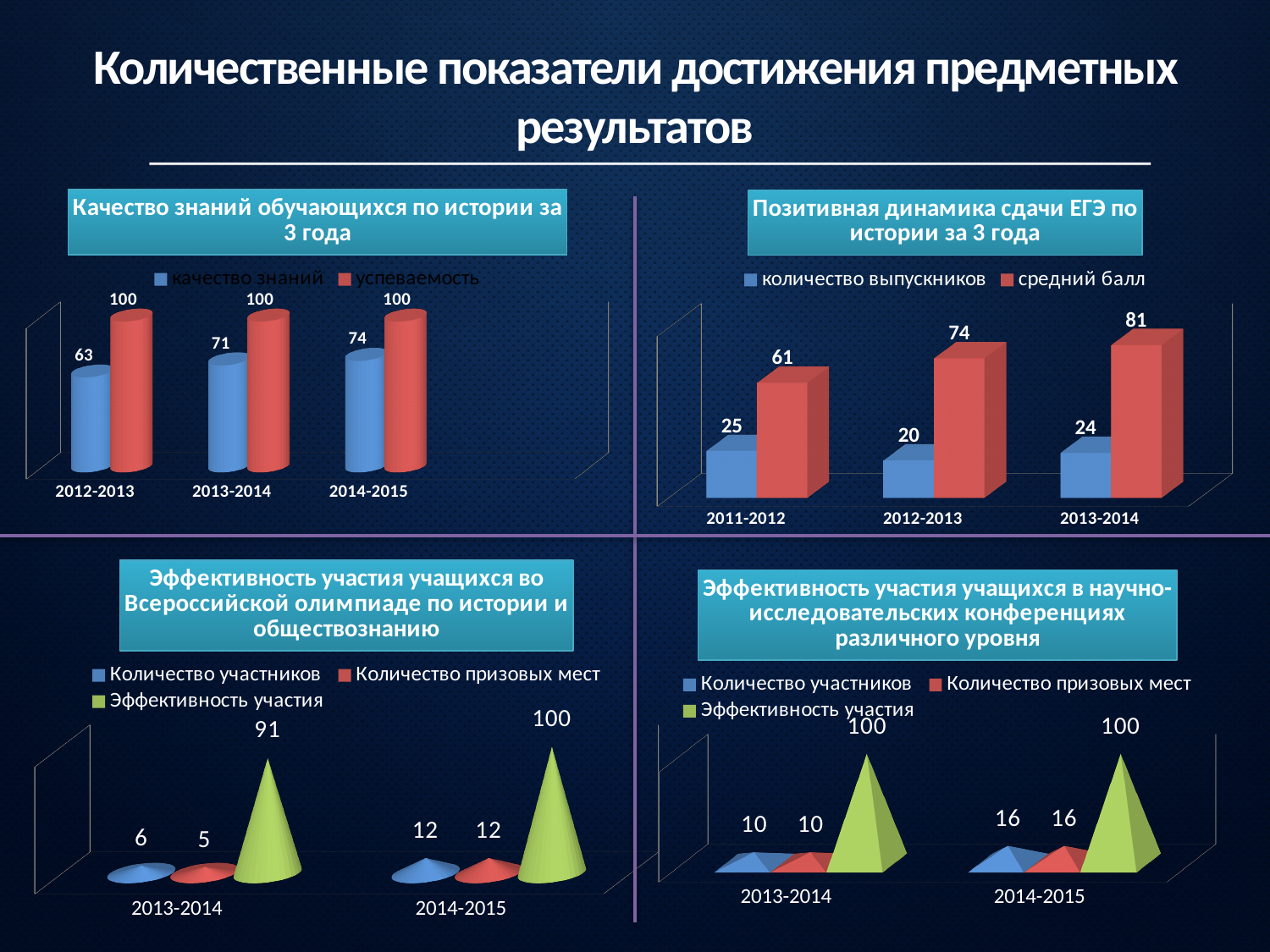
In the chart 'Эффективность участия учащихся в научно-исследовательских конференциях различного уровня', what is the 'Количество участников' for 2014-2015? 16 In the chart 'Эффективность участия учащихся во Всероссийской олимпиаде по истории и обществознанию', what is the 'Эффективность участия' value for 2013-2014? 91 In the chart 'Эффективность участия учащихся в научно-исследовательских конференциях различного уровня', how many year categories are shown on the x axis? 2 In the chart 'Позитивная динамика сдачи ЕГЭ по истории за 3 года', what is the 'средний балл' for 2013-2014? 81 In the chart 'Эффективность участия учащихся во Всероссийской олимпиаде по истории и обществознанию', what is the 'Количество призовых мест' for 2014-2015? 12 In the chart 'Качество знаний обучающихся по истории за 3 года', which year has the highest 'качество знаний' value? 2014-2015 In the chart 'Позитивная динамика сдачи ЕГЭ по истории за 3 года', which year has the lowest 'количество выпускников'? 2012-2013 In the chart 'Позитивная динамика сдачи ЕГЭ по истории за 3 года', how many series does the legend list? 2 In the chart 'Качество знаний обучающихся по истории за 3 года', does the 'качество знаний' value rise or fall from 2012-2013 to 2014-2015? rise In the chart 'Качество знаний обучающихся по истории за 3 года', what is the value of 'качество знаний' for 2012-2013? 63 In the chart 'Позитивная динамика сдачи ЕГЭ по истории за 3 года', what is the difference between the 'средний балл' for 2013-2014 and for 2011-2012? 20 What type of chart is 'Качество знаний обучающихся по истории за 3 года'? bar chart